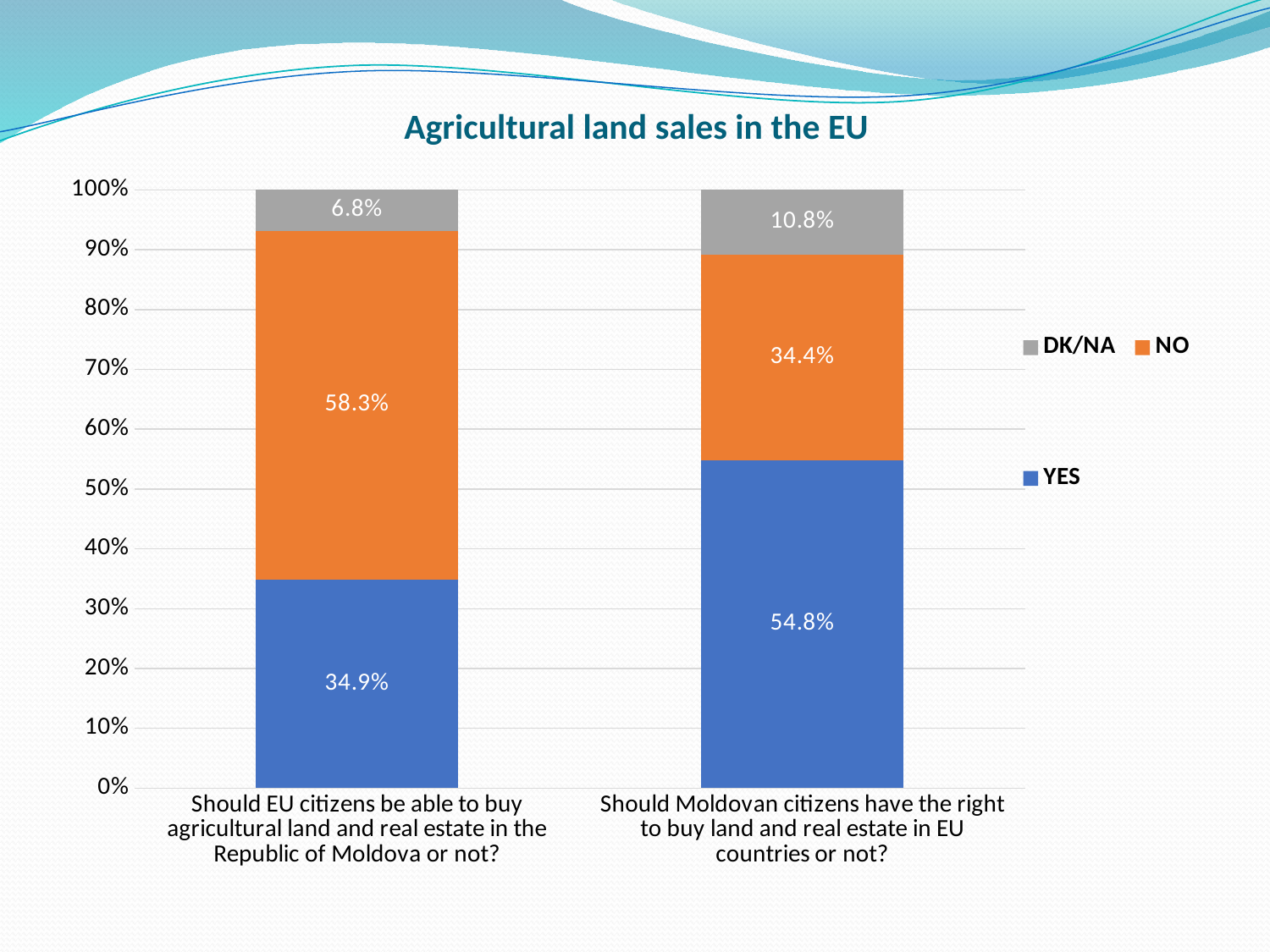
Which question has the lower NO share? Should Moldovan citizens have the right to buy land and real estate in EU countries or not? What is the title of the chart? Agricultural land sales in the EU What is the YES value for the question "Should EU citizens be able to buy agricultural land and real estate in the Republic of Moldova or not?"? 34.9% What is the difference between the NO values for the two questions? 23.9% What kind of chart is shown on the slide? Stacked bar chart Is the YES value larger for the EU citizens question or the Moldovan citizens question? Moldovan citizens question How many categories (questions) are shown on the x axis? 2 What is the DK/NA value for the question "Should EU citizens be able to buy agricultural land and real estate in the Republic of Moldova or not?"? 6.8% Which question has the higher YES share? Should Moldovan citizens have the right to buy land and real estate in EU countries or not? What is the NO value for the question "Should Moldovan citizens have the right to buy land and real estate in EU countries or not?"? 34.4% How many series does the legend list? 3 What is the DK/NA value for the question "Should Moldovan citizens have the right to buy land and real estate in EU countries or not?"? 10.8%